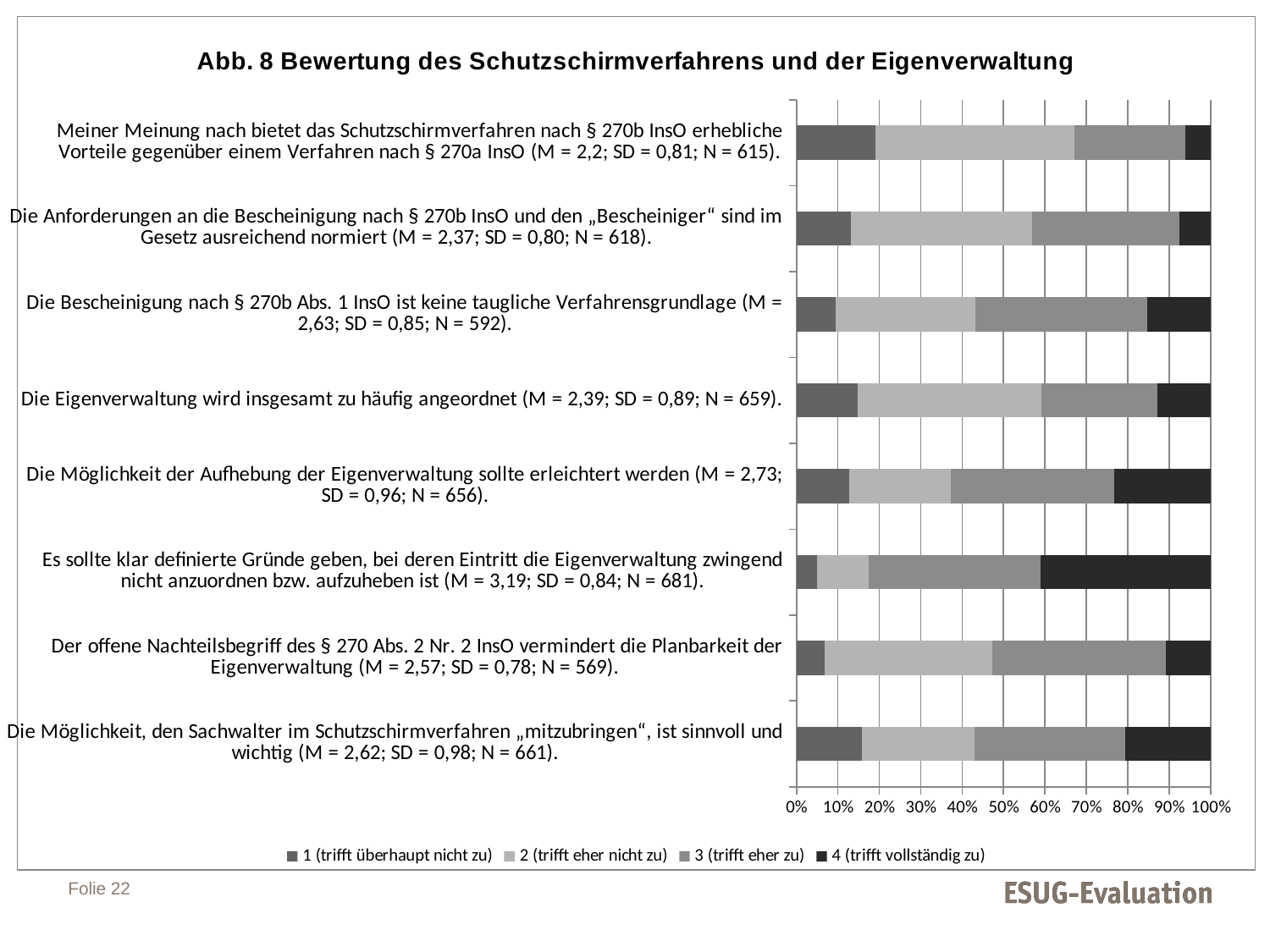
How many statements (categories) are plotted in the chart? 8 Is the share of '1 (trifft überhaupt nicht zu)' for the statement 'Meiner Meinung nach bietet das Schutzschirmverfahren nach § 270b InsO erhebliche Vorteile...' greater or less than 10%? greater Which legend entry is shown in the darkest (black) colour? 4 (trifft vollständig zu) What is the title of the chart? Abb. 8 Bewertung des Schutzschirmverfahrens und der Eigenverwaltung Is the share of '4 (trifft vollständig zu)' for the statement 'Es sollte klar definierte Gründe geben...' greater or less than 30%? greater Is the share of '1 (trifft überhaupt nicht zu)' for the statement 'Es sollte klar definierte Gründe geben...' greater or less than 10%? less For the statement 'Es sollte klar definierte Gründe geben...', which share is larger: '2 (trifft eher nicht zu)' or '4 (trifft vollständig zu)'? 4 (trifft vollständig zu) How many series does the legend list? 4 Which statement has the largest share of '4 (trifft vollständig zu)' responses? Es sollte klar definierte Gründe geben, bei deren Eintritt die Eigenverwaltung zwingend nicht anzuordnen bzw. aufzuheben ist What kind of chart is shown on the slide? Stacked bar chart For the statement 'Meiner Meinung nach bietet das Schutzschirmverfahren nach § 270b InsO erhebliche Vorteile...', which share is larger: '2 (trifft eher nicht zu)' or '3 (trifft eher zu)'? 2 (trifft eher nicht zu)